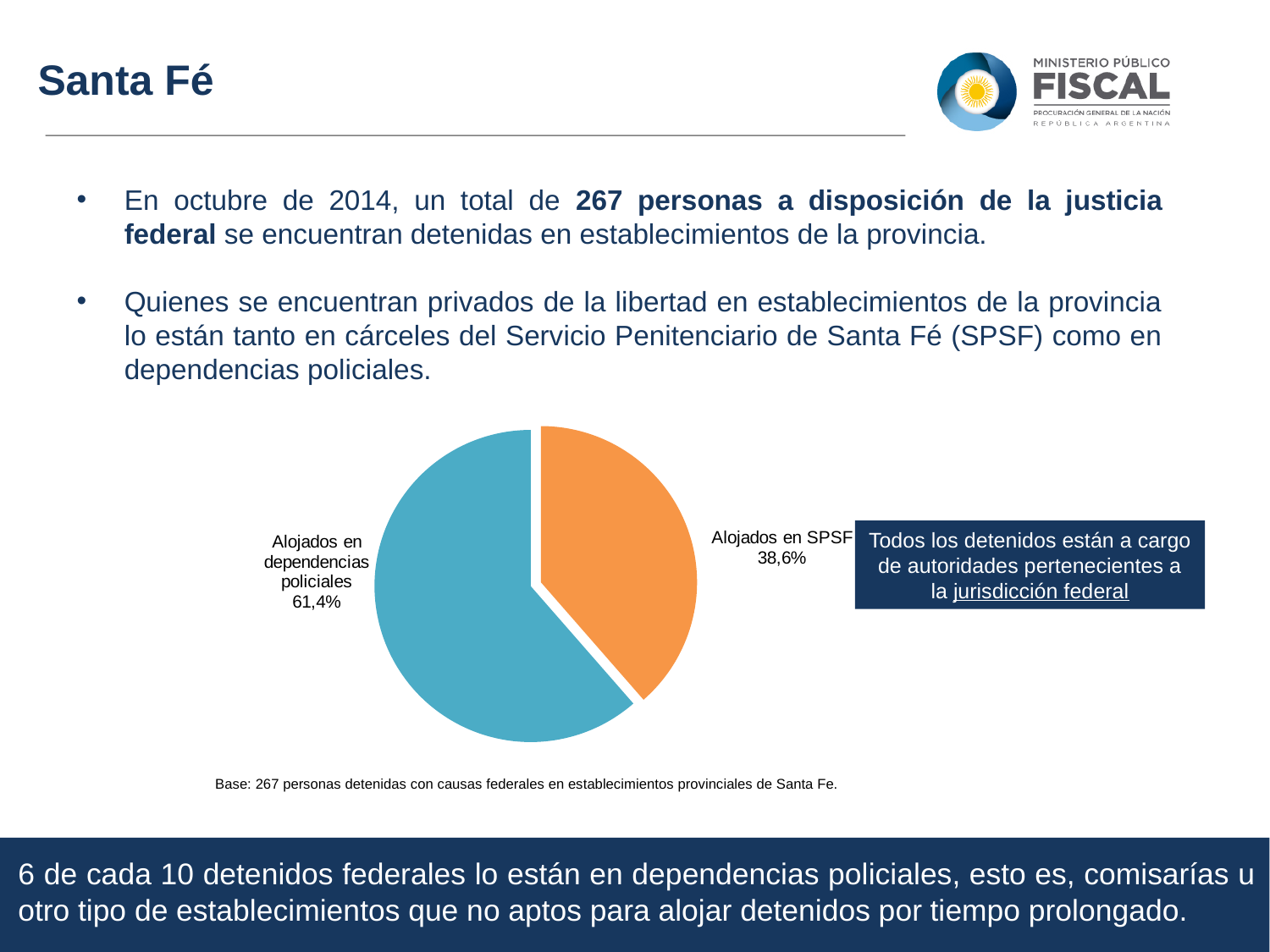
How many slices does the pie chart have? 2 What colour is the 'Alojados en dependencias policiales' slice? blue Which slice of the pie chart is the smallest? Alojados en SPSF Which slice of the pie chart is the largest? Alojados en dependencias policiales What colour is the 'Alojados en SPSF' slice? orange According to the base note under the chart, how many detained persons does the pie chart represent? 267 What share of the pie is 'Alojados en SPSF'? 38,6% What is the difference in percentage points between the 'Alojados en dependencias policiales' slice and the 'Alojados en SPSF' slice? 22,8 What share of the pie is 'Alojados en dependencias policiales'? 61,4% What kind of chart is shown on the slide? pie chart Which is larger: the share for 'Alojados en SPSF' or the share for 'Alojados en dependencias policiales'? Alojados en dependencias policiales